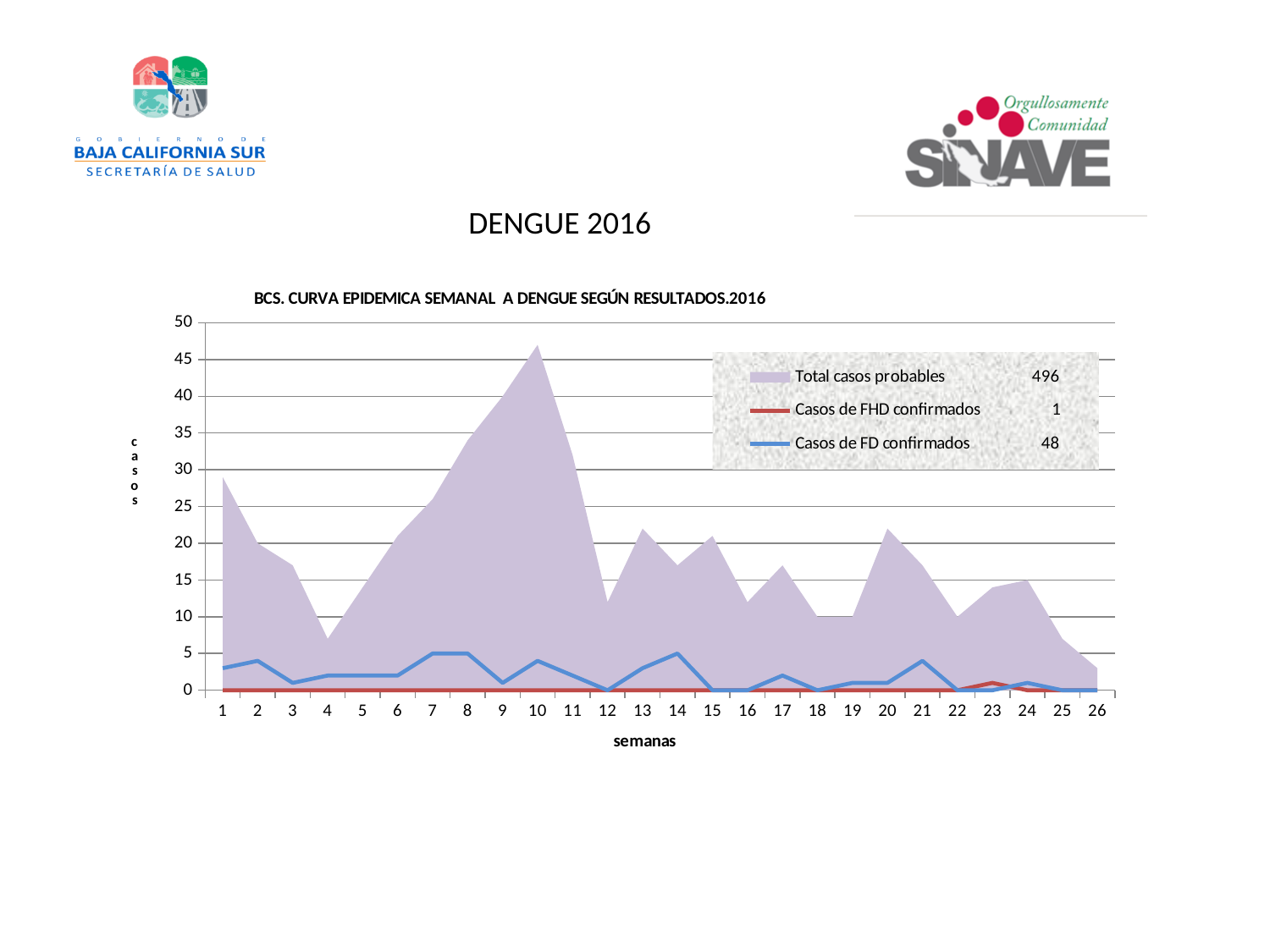
Which week has more Total casos probables, week 18 or week 20? week 20 Is the value of Total casos probables in week 10 greater or less than 40? greater What total is shown in the legend for Total casos probables? 496 Which week has more Total casos probables, week 10 or week 13? week 10 Is the value of Total casos probables in week 4 greater or less than 10? less Is the value of Total casos probables in week 1 greater or less than 25? greater What kind of chart is shown on the slide? combination area and line chart In which week do the Total casos probables reach their highest value? 10 How many weeks (semanas) are shown on the x axis of the chart? 26 What total is shown in the legend for Casos de FD confirmados? 48 How many series does the chart legend list? 3 Do the Total casos probables rise or fall from week 10 to week 12? fall